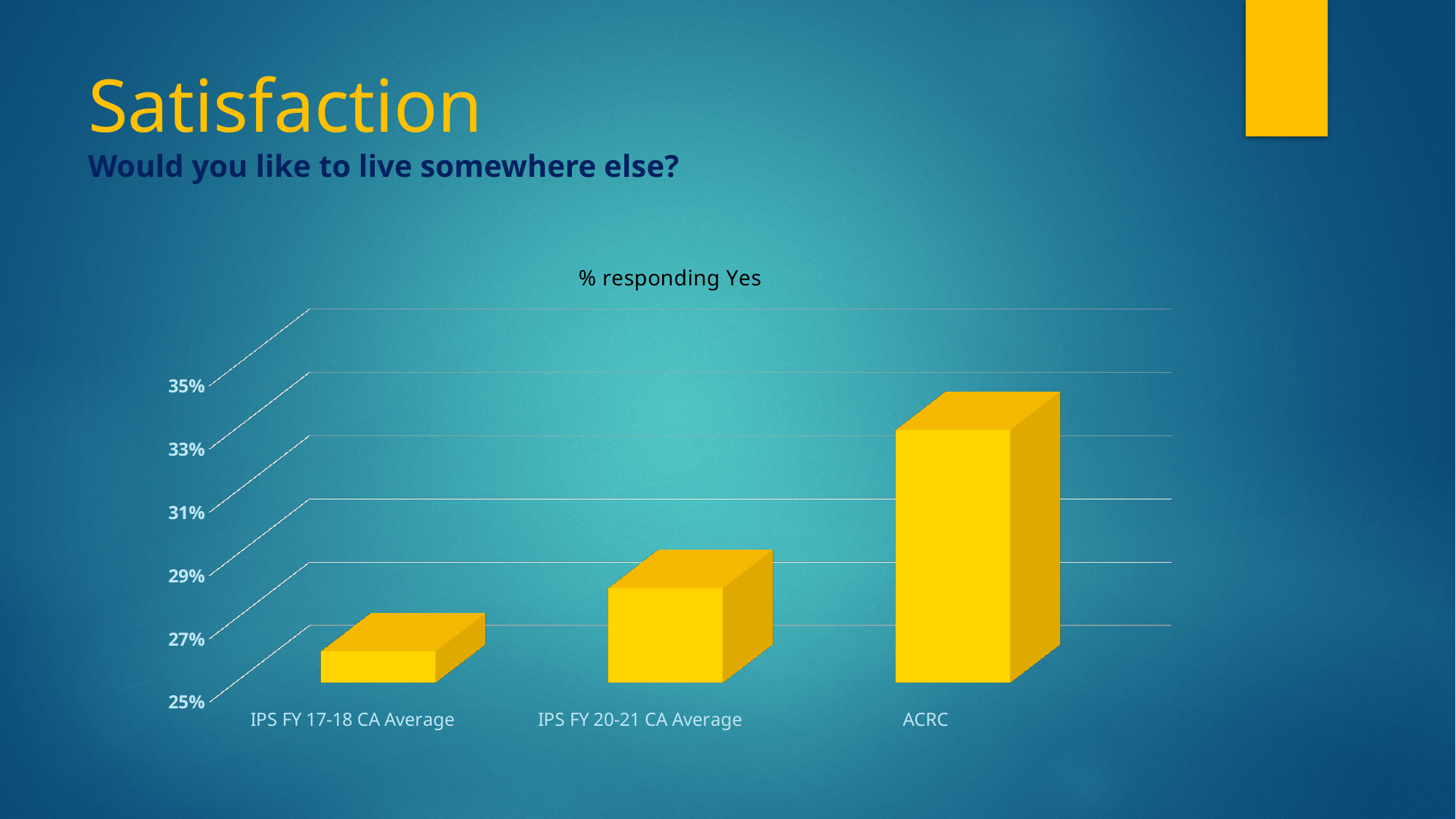
Which category has the lowest value? IPS FY 17-18 CA Average Is the value for IPS FY 17-18 CA Average greater or less than 27%? less Which is larger, the value for ACRC or the value for IPS FY 20-21 CA Average? ACRC Do the values rise or fall from left to right across the categories? rise Is the value for ACRC greater or less than 31%? greater Is the value for IPS FY 20-21 CA Average greater or less than 29%? less What kind of chart is shown on the slide? bar chart Which is larger, the value for IPS FY 17-18 CA Average or the value for IPS FY 20-21 CA Average? IPS FY 20-21 CA Average What is the title of the chart? % responding Yes How many categories are plotted in the chart? 3 Which category has the highest value? ACRC